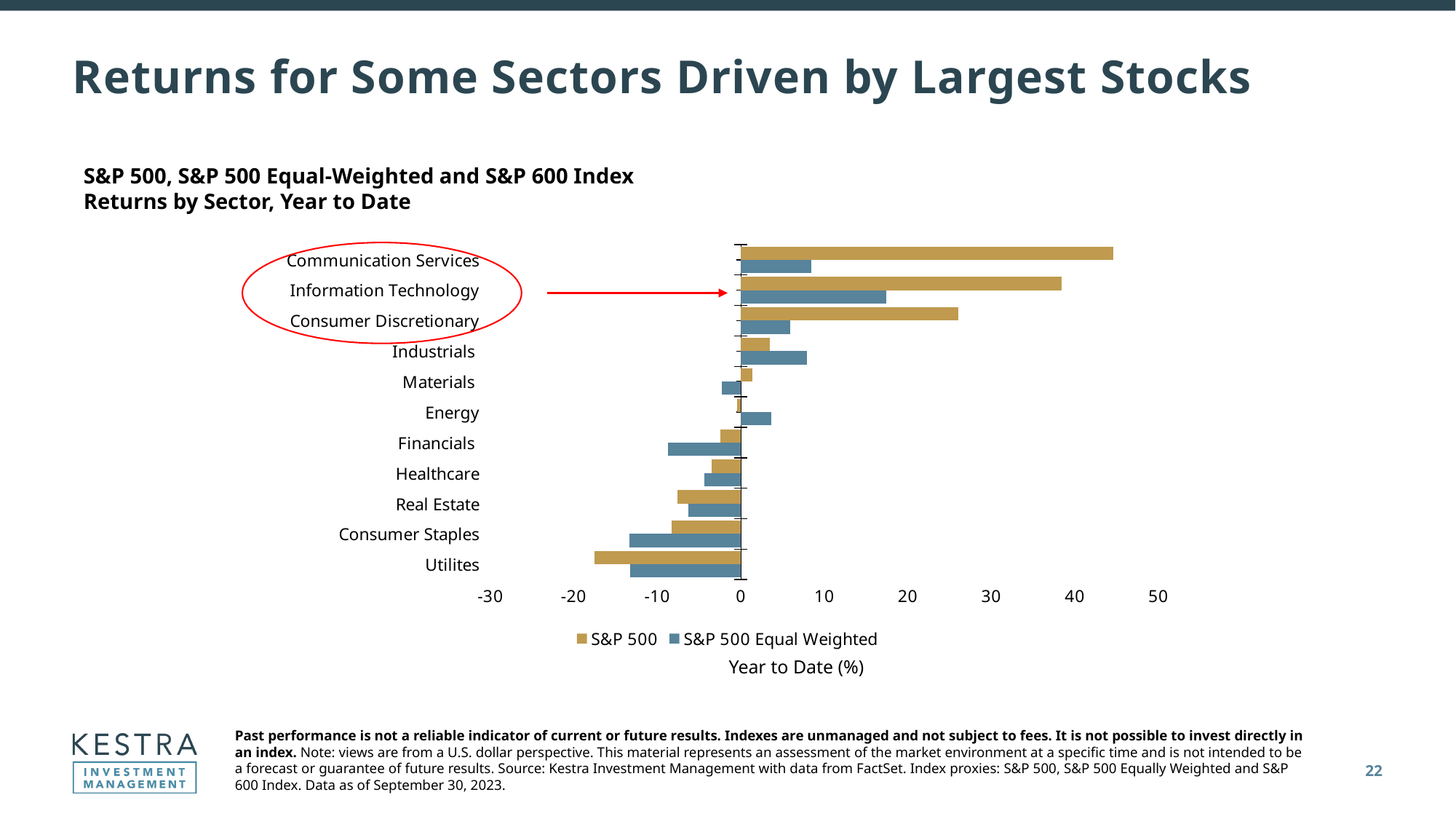
Is the S&P 500 Equal Weighted value for Information Technology greater or less than 20? less For Industrials, which is larger: the S&P 500 return or the S&P 500 Equal Weighted return? S&P 500 Equal Weighted Which sector has the highest S&P 500 Equal Weighted year-to-date return? Information Technology Which sector has the highest S&P 500 year-to-date return? Communication Services How many sectors are listed on the chart? 11 Is the S&P 500 value for Communication Services greater or less than 40? greater What kind of chart is shown on the slide? Bar chart How many series does the chart's legend list? 2 Which sector has the lowest S&P 500 year-to-date return? Utilites What is the label of the horizontal axis of the chart? Year to Date (%) Is the S&P 500 value for Utilites greater or less than -10? less For Information Technology, which is larger: the S&P 500 return or the S&P 500 Equal Weighted return? S&P 500